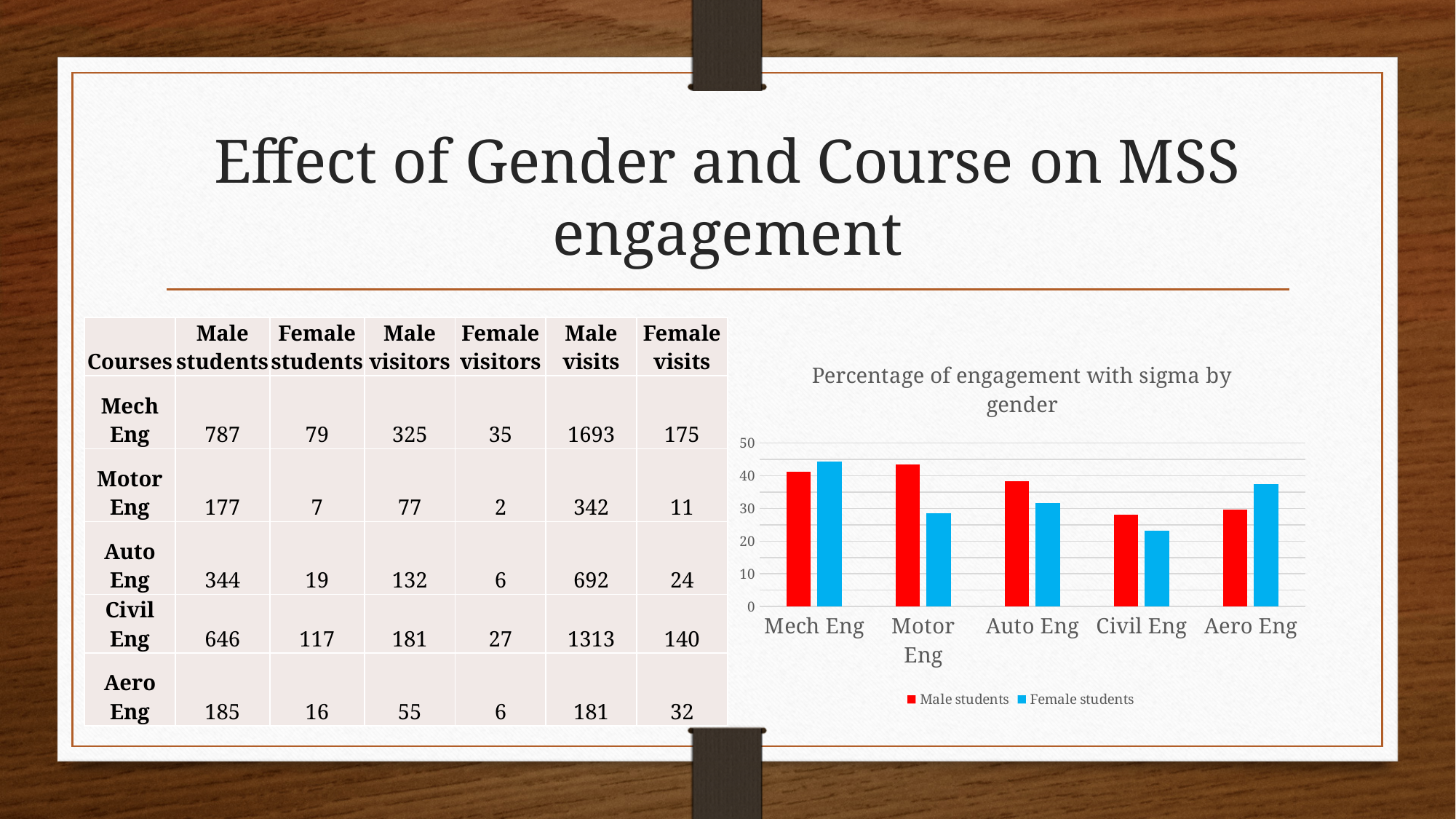
How many series does the chart legend list? 2 Is the value for Male students in Motor Eng greater or less than 40? greater Which course has the lowest value for Female students? Civil Eng How many courses are shown on the x axis of the chart? 5 Which course has the highest value for Female students? Mech Eng Is the value for Female students in Civil Eng greater or less than 30? less For Aero Eng, which is larger: Male students or Female students? Female students For Motor Eng, which is larger: Male students or Female students? Male students Is the value for Male students in Auto Eng greater or less than 30? greater Which colour represents Female students in the chart? blue What kind of chart is shown on the slide? bar chart What is the title of the chart? Percentage of engagement with sigma by gender